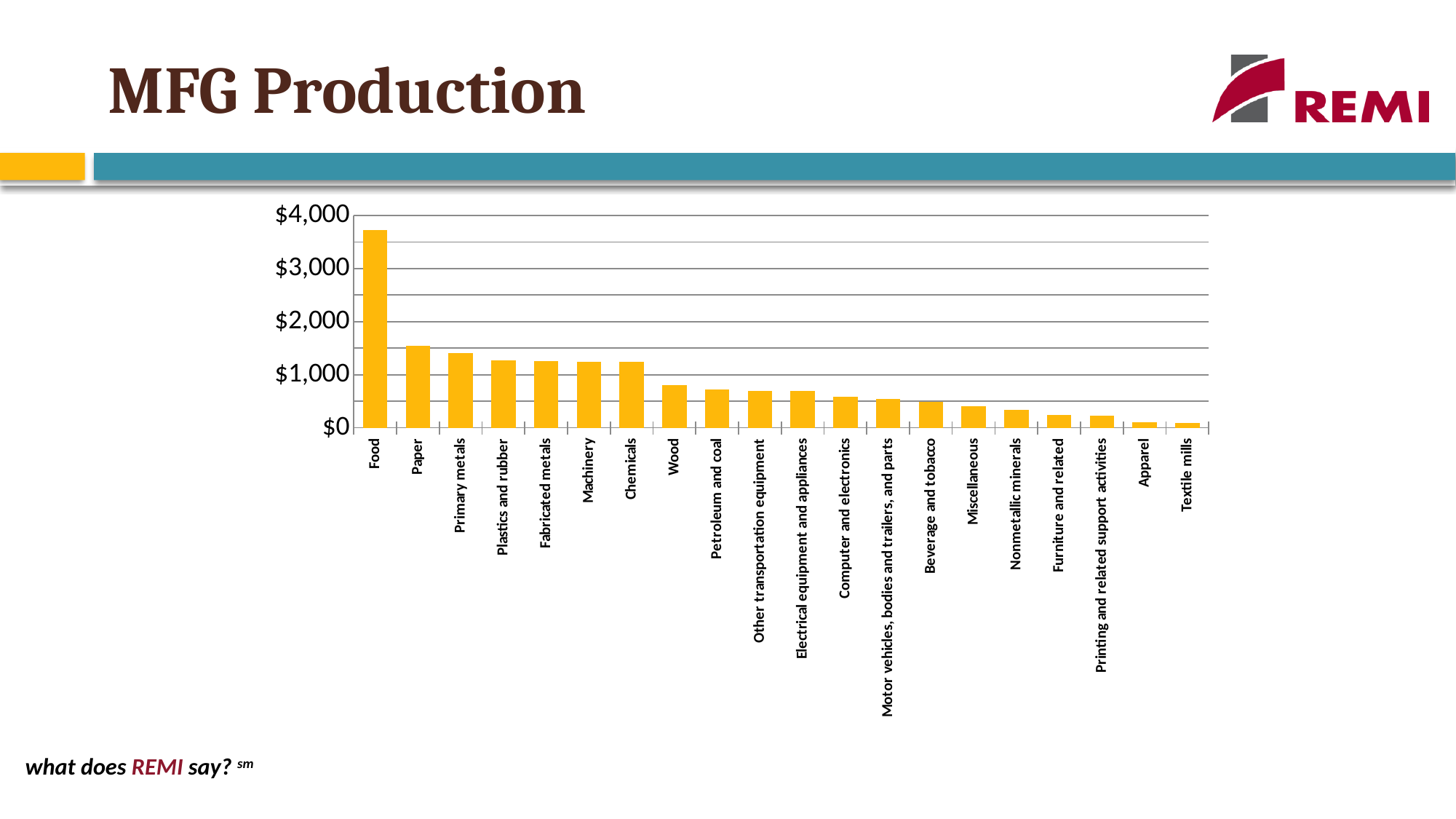
Which category has the highest value? Food Which is larger, the value for Food or the value for Paper? Food Is the value for Primary metals greater or less than $2,000? less Is the value for Paper greater or less than $1,000? greater How many categories are plotted on the chart? 20 What colour are the bars in the chart? yellow/orange What kind of chart is shown on the slide? bar chart Is the value for Wood greater or less than $1,000? less Do the values rise or fall moving from left to right along the x axis? fall Which is larger, the value for Wood or the value for Nonmetallic minerals? Wood What is the title of the slide containing the chart? MFG Production